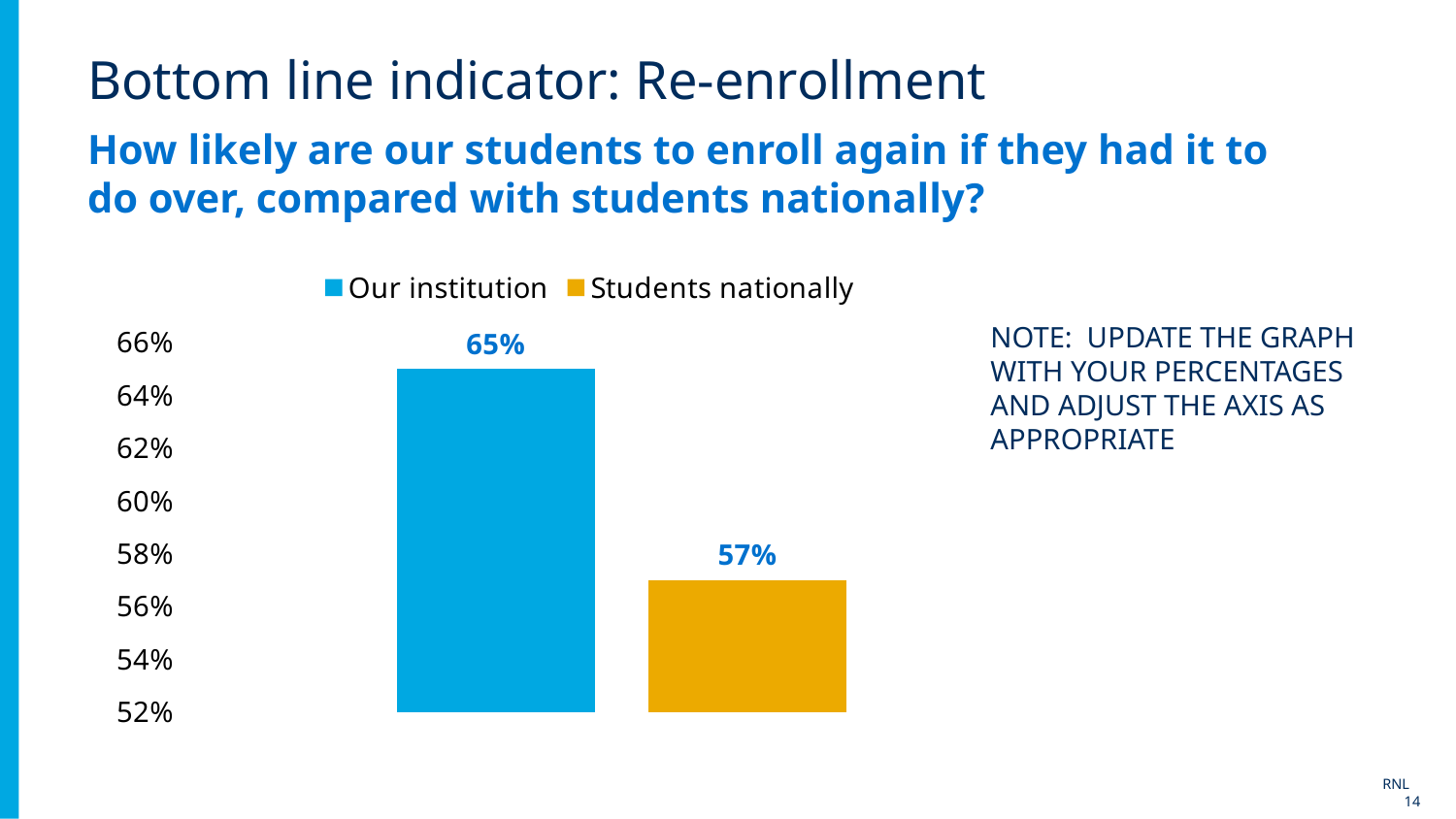
Which series has the lower value? Students nationally Which series has the higher value? Our institution Is the value for Our institution greater or less than 64%? greater What is the value for Our institution? 65% What colour is the bar for Students nationally? yellow What kind of chart is shown on the slide? bar chart What is the difference between the Our institution value and the Students nationally value? 8% What is the value for Students nationally? 57% How many bars are plotted in the chart? 2 How many series does the legend list? 2 Is the value for Our institution larger or smaller than the value for Students nationally? larger Is the value for Students nationally greater or less than 60%? less